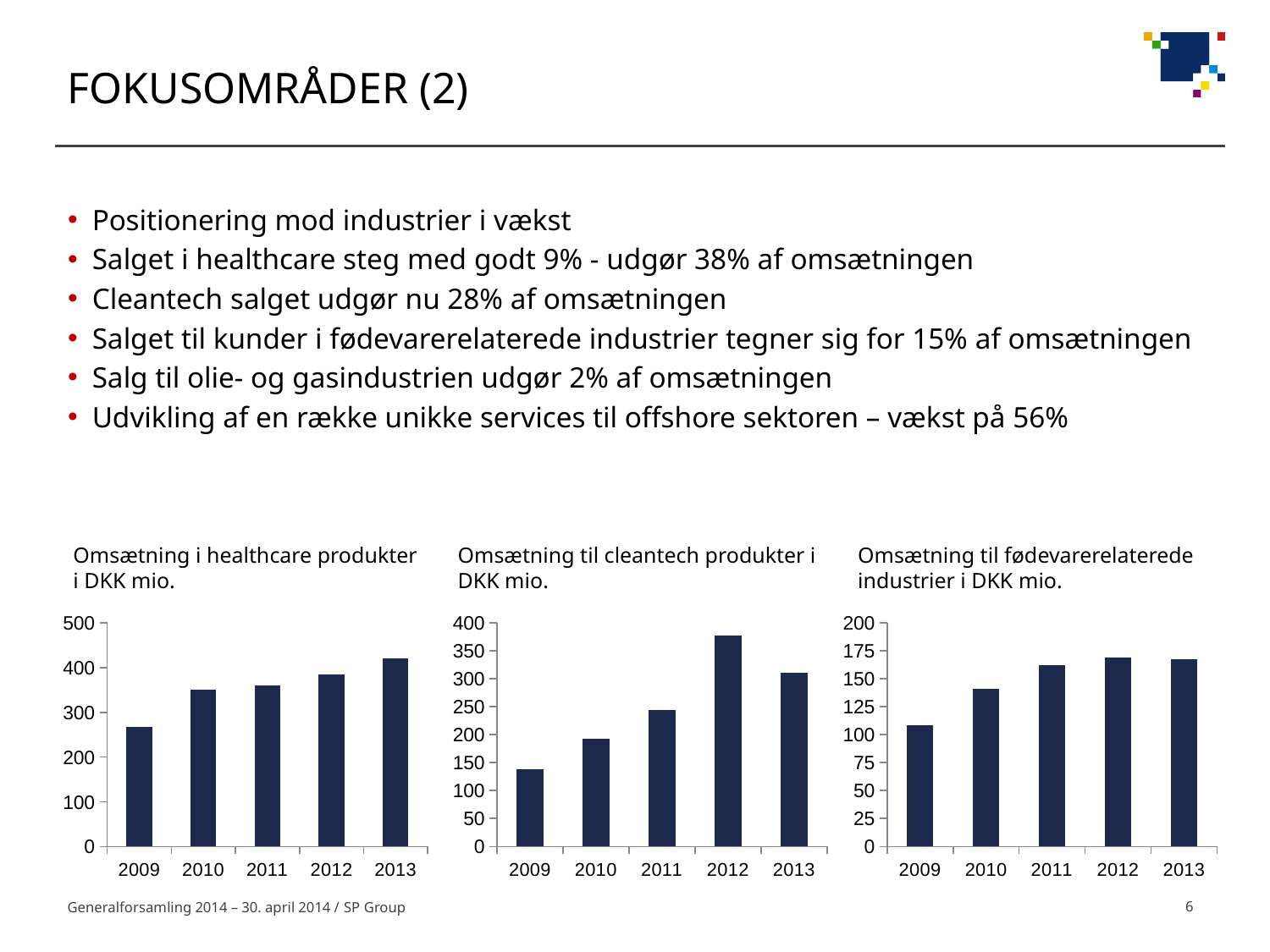
In the 'Omsætning i healthcare produkter i DKK mio.' chart, which year has the lowest value? 2009 How many years are plotted in the 'Omsætning til cleantech produkter i DKK mio.' chart? 5 In the 'Omsætning til cleantech produkter i DKK mio.' chart, which year has the highest value? 2012 In the 'Omsætning i healthcare produkter i DKK mio.' chart, do the values generally rise or fall from 2009 to 2013? rise In the 'Omsætning til cleantech produkter i DKK mio.' chart, which is larger, the value for 2012 or the value for 2013? 2012 How many charts are shown on the slide? 3 In the 'Omsætning til cleantech produkter i DKK mio.' chart, is the value for 2012 greater or less than 350? greater In the 'Omsætning i healthcare produkter i DKK mio.' chart, which year has the highest value? 2013 In the 'Omsætning til fødevarerelaterede industrier i DKK mio.' chart, which year has the lowest value? 2009 In the 'Omsætning til cleantech produkter i DKK mio.' chart, which year has the lowest value? 2009 In the 'Omsætning i healthcare produkter i DKK mio.' chart, is the value for 2013 greater or less than 400? greater What kind of chart is the 'Omsætning i healthcare produkter i DKK mio.' chart? bar chart